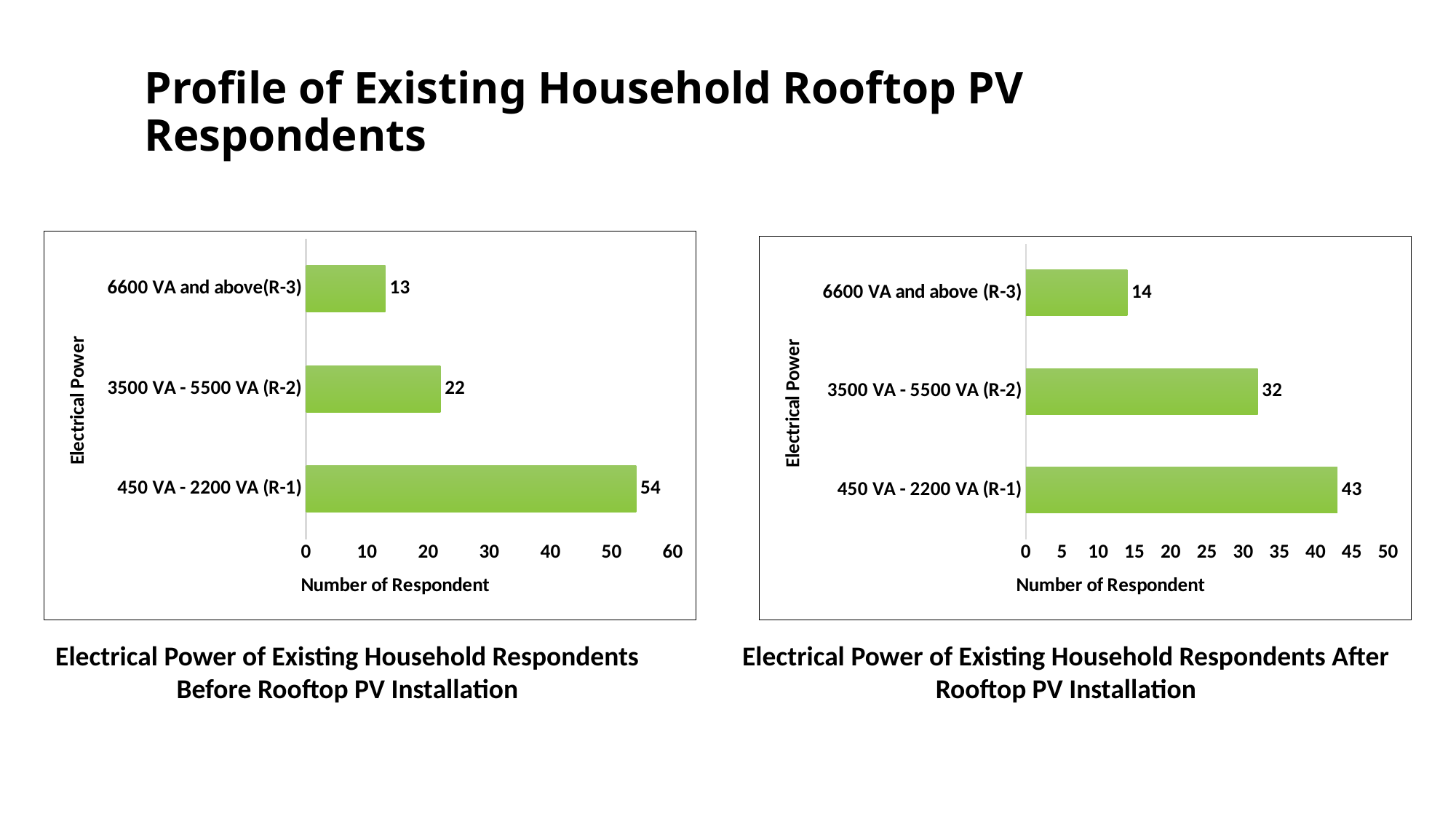
In the left chart (Before Rooftop PV Installation), what is the difference between the number of respondents in 450 VA - 2200 VA (R-1) and 3500 VA - 5500 VA (R-2)? 32 Which chart shows a larger value for 6600 VA and above (R-3): the Before chart on the left or the After chart on the right? the After chart on the right What is the y-axis label of the left chart (Before Rooftop PV Installation)? Electrical Power In the right chart (After Rooftop PV Installation), how many respondents are in the 3500 VA - 5500 VA (R-2) category? 32 What is the x-axis label of the right chart (After Rooftop PV Installation)? Number of Respondent How many electrical power categories are shown in the right chart (After Rooftop PV Installation)? 3 In the left chart (Before Rooftop PV Installation), how many respondents are in the 450 VA - 2200 VA (R-1) category? 54 In the left chart (Before Rooftop PV Installation), which electrical power category has the fewest respondents? 6600 VA and above(R-3) In the right chart (After Rooftop PV Installation), which electrical power category has the most respondents? 450 VA - 2200 VA (R-1) In the right chart (After Rooftop PV Installation), what is the difference between the number of respondents in 3500 VA - 5500 VA (R-2) and 6600 VA and above (R-3)? 18 In the left chart (Before Rooftop PV Installation), is the value for 3500 VA - 5500 VA (R-2) greater or less than 30? less What type of chart is the left chart (Before Rooftop PV Installation)? bar chart